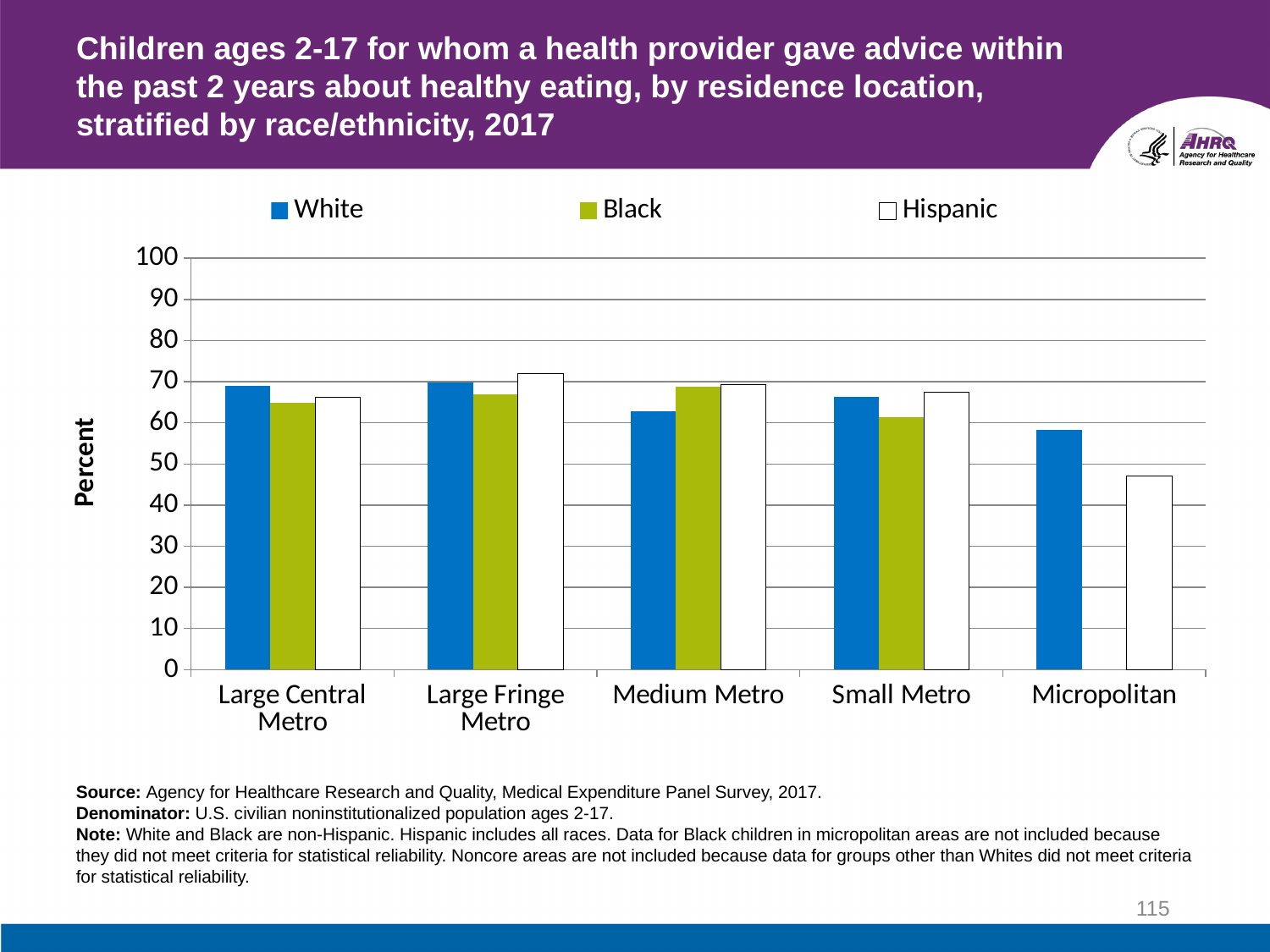
In Micropolitan areas, which is larger: the value for White or for Hispanic children? White Is the value for Black children in Small Metro areas greater or less than 70? less How many series does the legend list? 3 How many residence location categories are shown on the x axis? 5 In Medium Metro areas, which is larger: the value for White or for Black children? Black In Small Metro areas, which is larger: the value for Black or for Hispanic children? Hispanic What kind of chart is shown on the slide? Bar chart Is the value for White children in Large Fringe Metro areas greater or less than 60? greater For the Hispanic series, which residence location has the lowest value? Micropolitan Is the value for Hispanic children in Micropolitan areas greater or less than 50? less Which residence location category has no bar for the Black series? Micropolitan